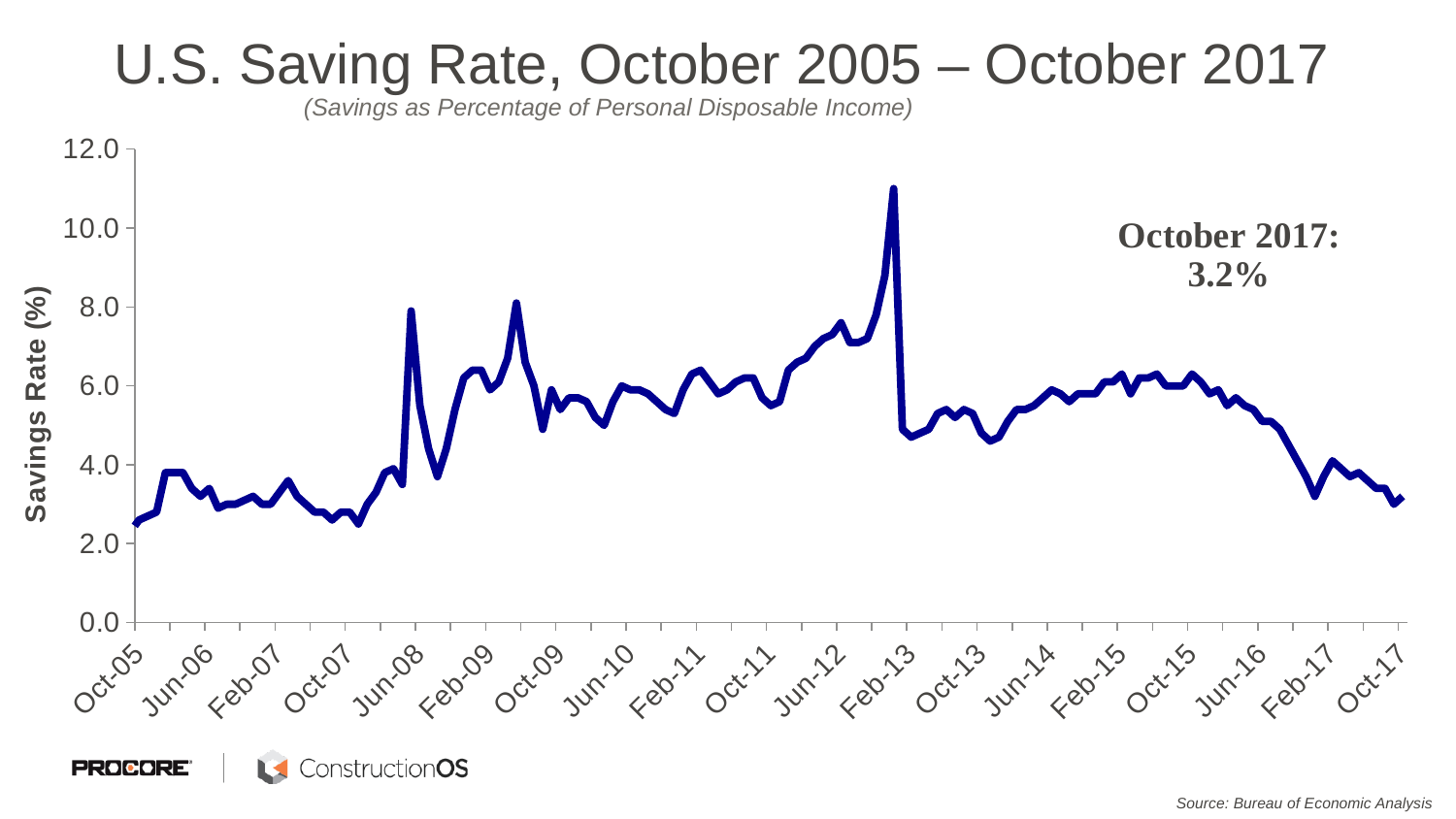
Which is larger, the value for Feb-15 or the value for Oct-17? Feb-15 Is the highest point on the line greater or less than 10.0? greater What is the title of the y-axis? Savings Rate (%) How many lines are plotted on the chart? 1 Is the value for Oct-05 greater or less than 4.0? less What is the saving rate for October 2017 as printed on the chart? 3.2% What kind of chart is shown on the slide? line chart Is the value for Oct-17 greater or less than 6.0? less Which is larger, the spike near Jun-08 or the spike just before Feb-13? the spike just before Feb-13 From Oct-13 to Feb-15, does the line generally rise or fall? rise From Feb-15 to Oct-17, does the line generally rise or fall? fall